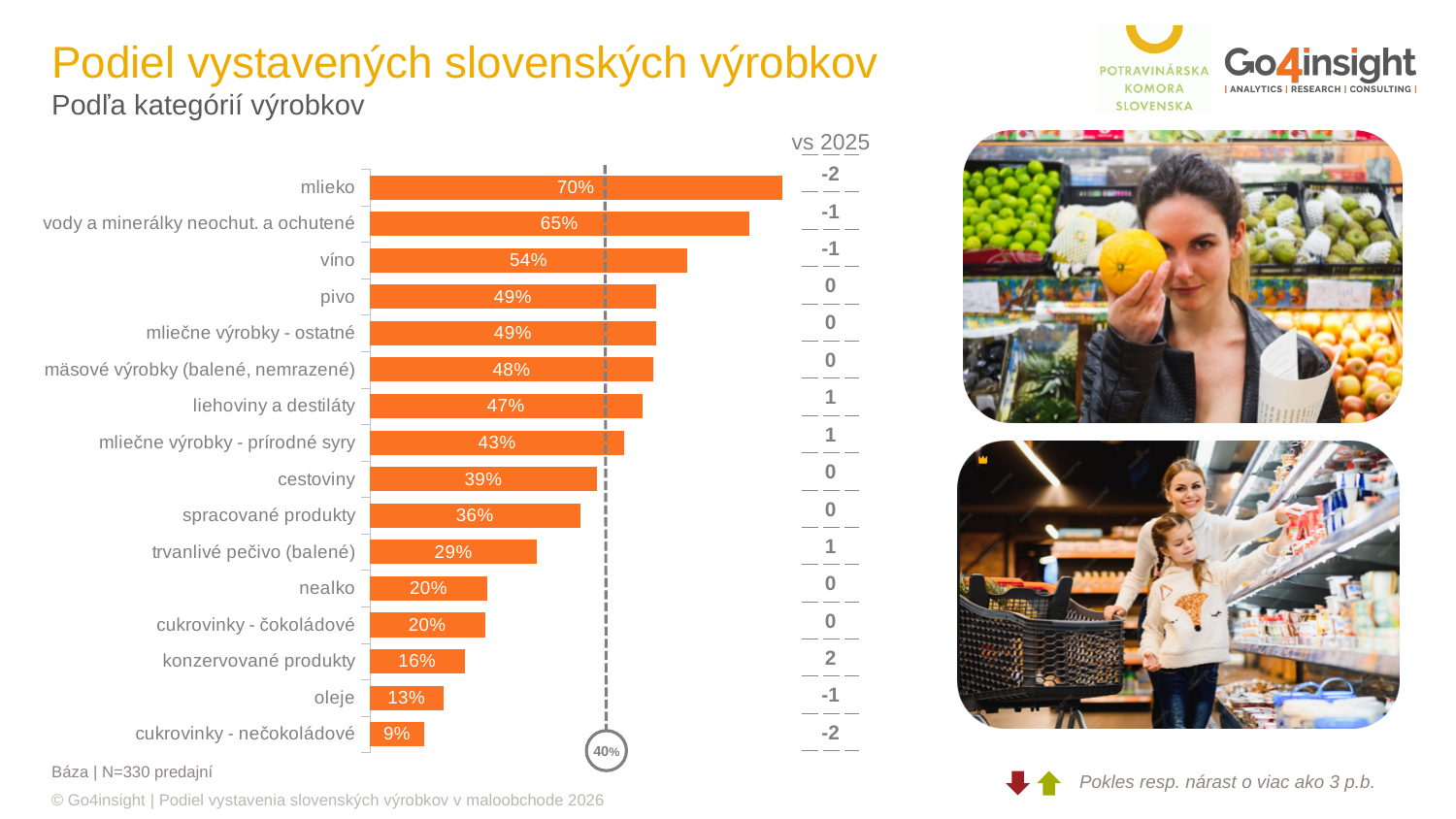
How many categories are shown in the chart? 16 What is the 'vs 2025' change shown for konzervované produkty? 2 What value does the dashed vertical reference line in the chart mark? 40% What is the 'vs 2025' change shown for mlieko? -2 What is the value for mlieko? 70% What is the value for oleje? 13% Which category has the lowest value? cukrovinky - nečokoládové Which category has the highest value? mlieko Which is larger, the value for pivo or the value for trvanlivé pečivo (balené)? pivo What is the value for cestoviny? 39% What kind of chart is shown on the slide? bar chart What is the difference between the values for mlieko and víno? 16%